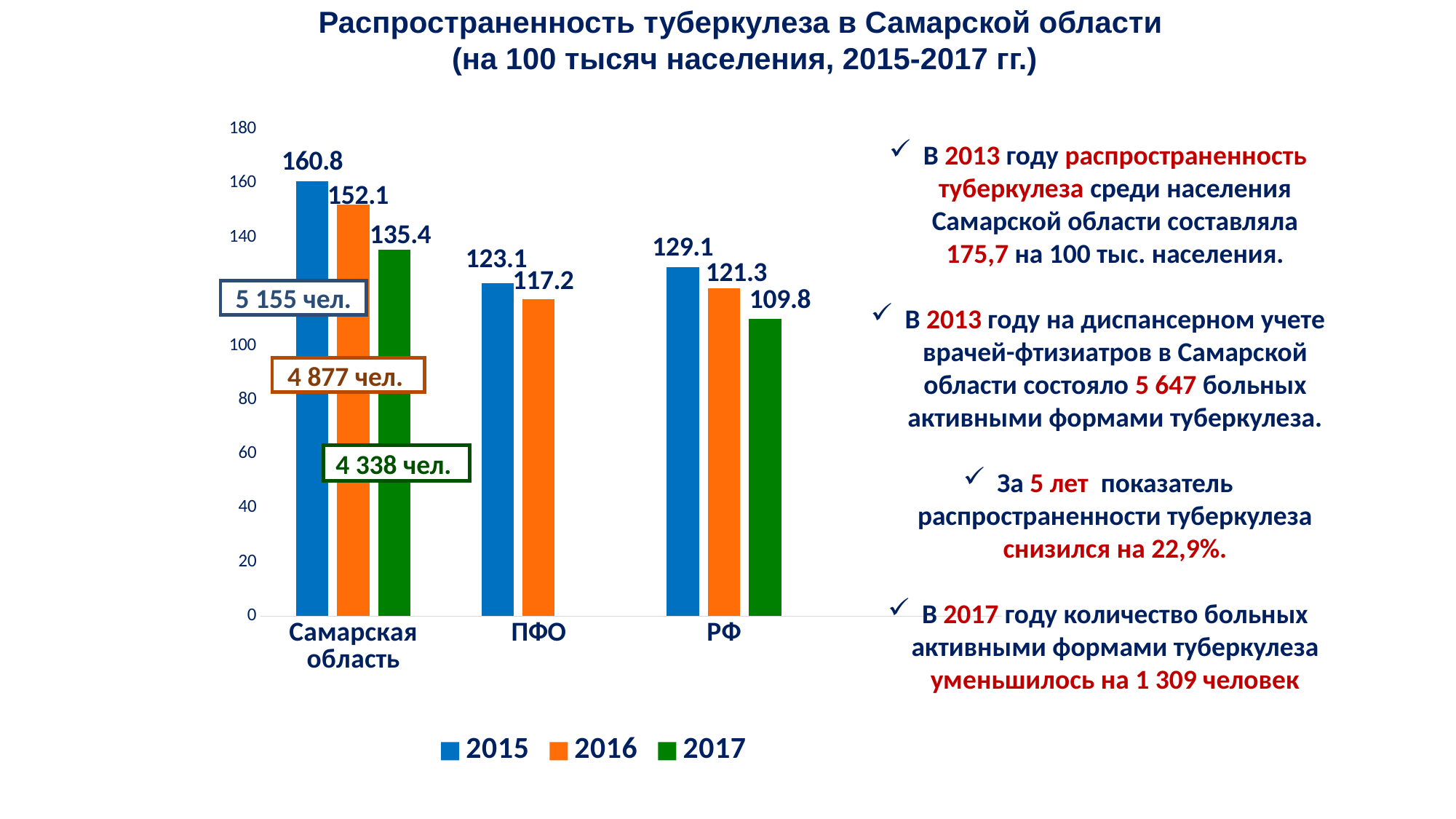
How many series does the legend list? 3 What is the value for ПФО in 2016? 117.2 Is the 2017 value for Самарская область greater or less than 120? greater Which category has the highest value in 2015? Самарская область Which is larger: the 2015 value for ПФО or the 2015 value for РФ? РФ How many categories are shown on the x axis? 3 What is the value for Самарская область in 2015? 160.8 Which category has the lowest value in 2016? ПФО Do the values for РФ rise or fall from 2015 to 2017? fall What is the value for РФ in 2017? 109.8 What kind of chart is shown on the slide? bar chart What is the difference between the 2015 and 2017 values for Самарская область? 25.4